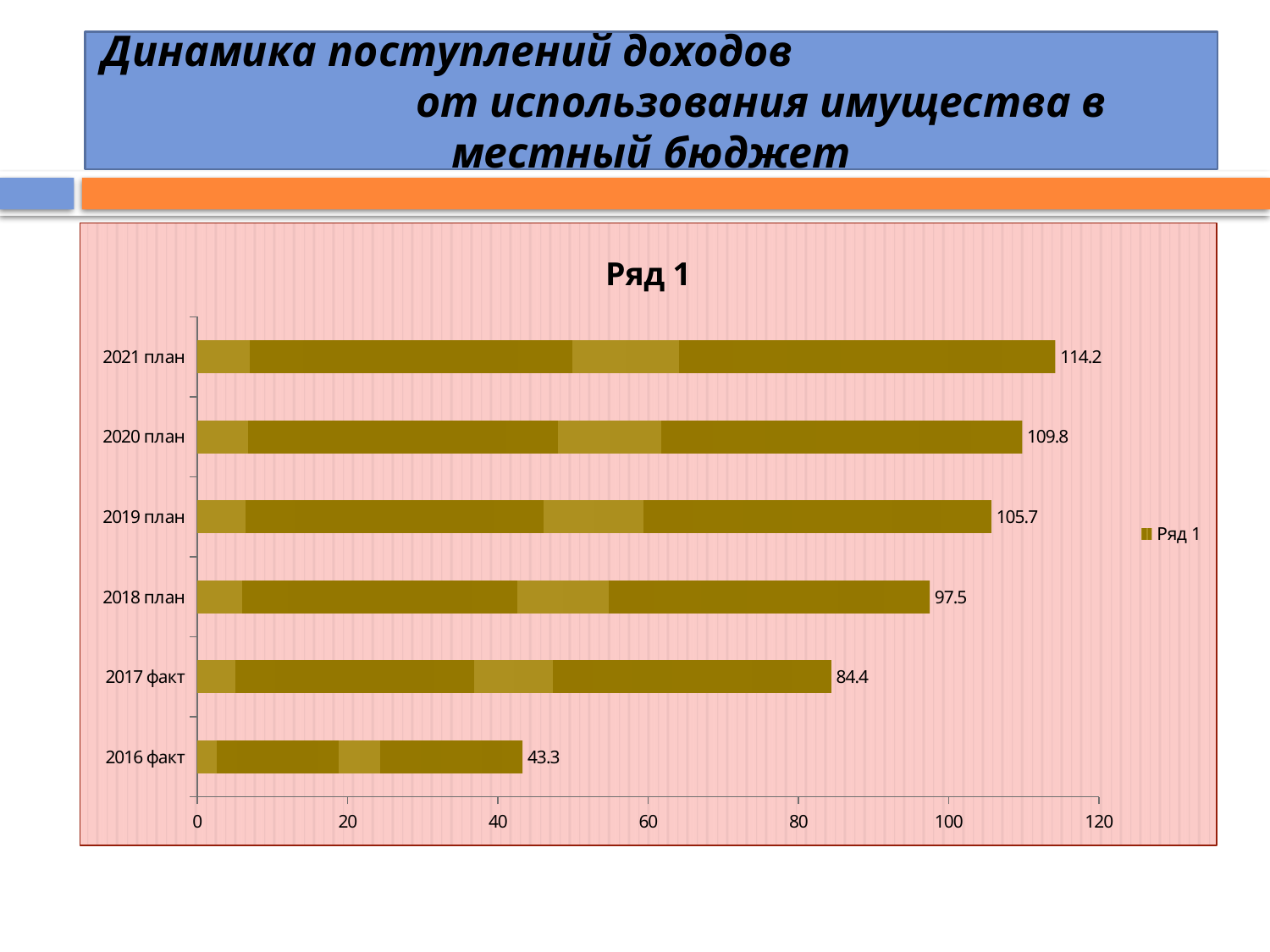
What is the difference between the values for 2021 план and 2020 план? 4.4 Which is larger, the value for 2019 план or the value for 2018 план? 2019 план What is the value for 2016 факт? 43.3 Which category has the lowest value? 2016 факт How many categories are shown in the chart? 6 Which category has the highest value? 2021 план What is the difference between the values for 2017 факт and 2016 факт? 41.1 Is the value for 2017 факт greater or less than 80? greater What kind of chart is shown on the slide? bar chart What is the value for 2018 план? 97.5 What is the name of the series shown in the legend? Ряд 1 What is the value for 2021 план? 114.2